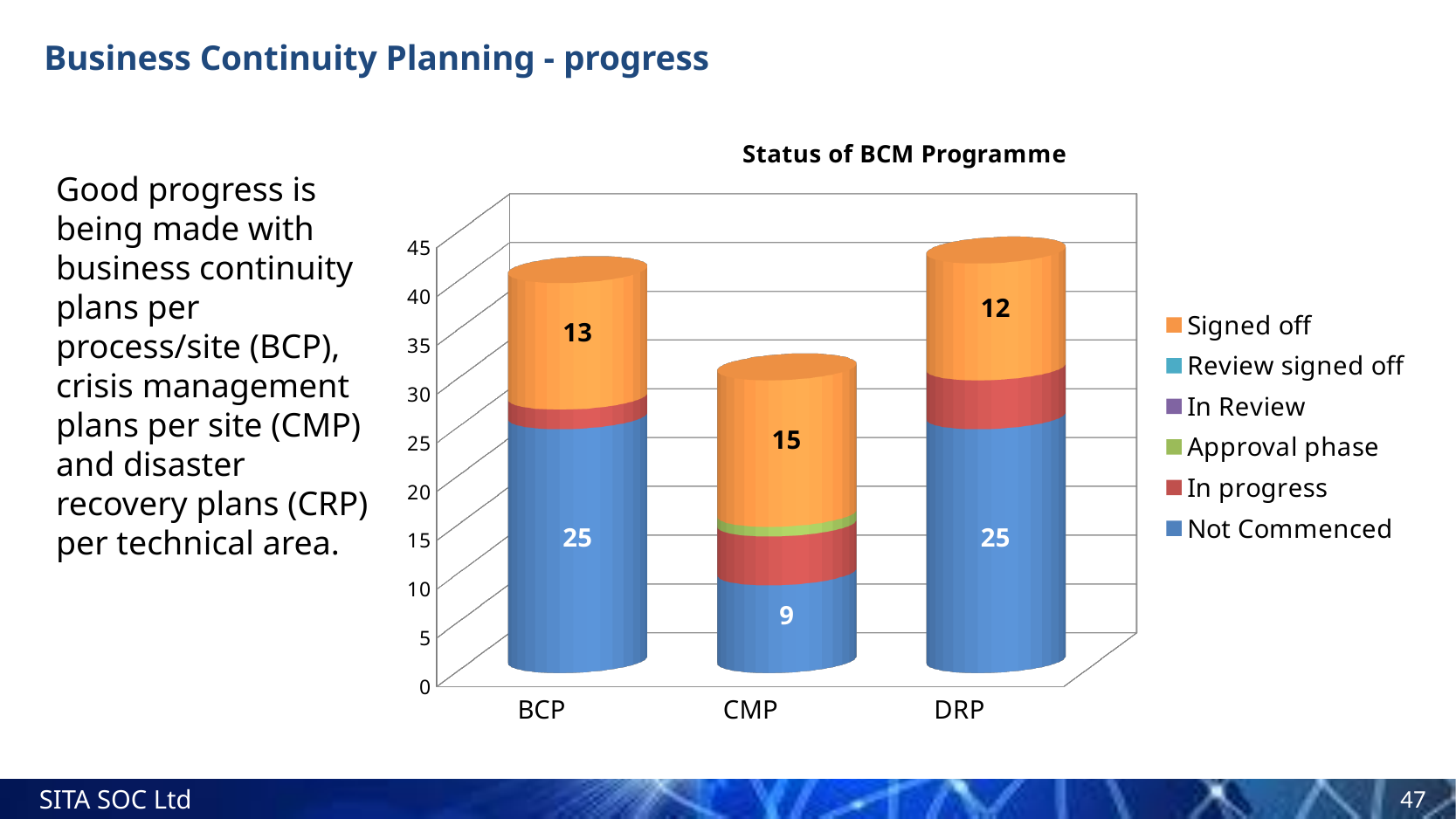
What is the Not Commenced value for CMP? 9 How many categories are shown on the x axis? 3 How many series does the legend list? 6 What is the Signed off value for DRP? 12 Which category has the lowest Not Commenced value? CMP What is the title of the chart? Status of BCM Programme What is the Signed off value for CMP? 15 What is the Not Commenced value for BCP? 25 Which is larger, the Signed off value for BCP or for DRP? BCP Which category has the highest Signed off value? CMP What is the difference between the Not Commenced values for BCP and CMP? 16 What is the difference between the Signed off values for CMP and DRP? 3